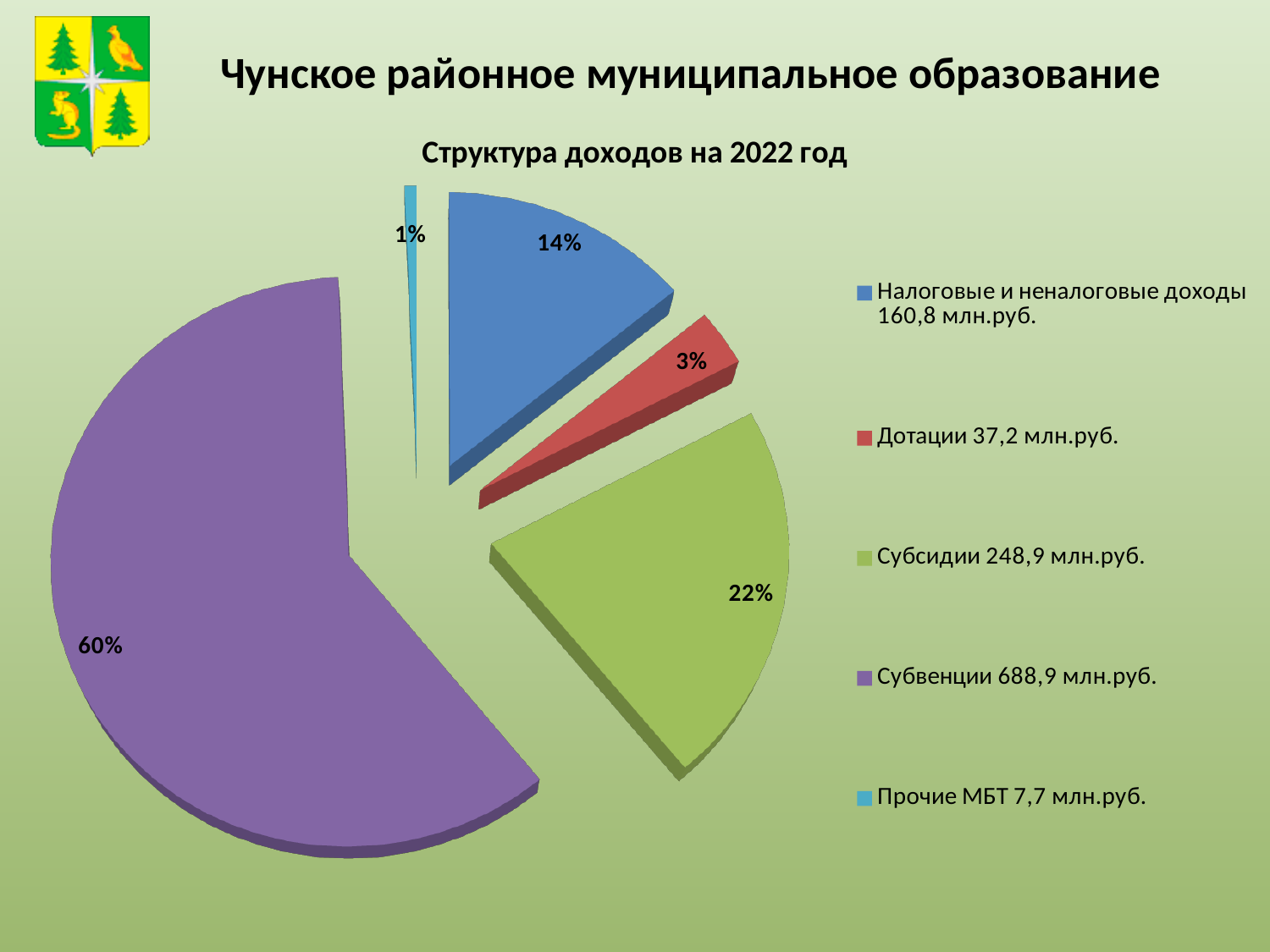
What is the difference in percentage points between the Субвенции slice and the Субсидии slice? 38 What share of the pie does Дотации account for? 3% What share of the pie does Налоговые и неналоговые доходы account for? 14% What kind of chart is shown on the slide? Pie chart What share of the pie does Субсидии account for? 22% Which category has the smallest slice of the pie? Прочие МБТ Which slice is larger, Налоговые и неналоговые доходы or Дотации? Налоговые и неналоговые доходы What amount in млн.руб. does the legend give for Субвенции? 688,9 млн.руб. How many slices does the pie chart have? 5 Which category has the largest slice of the pie? Субвенции